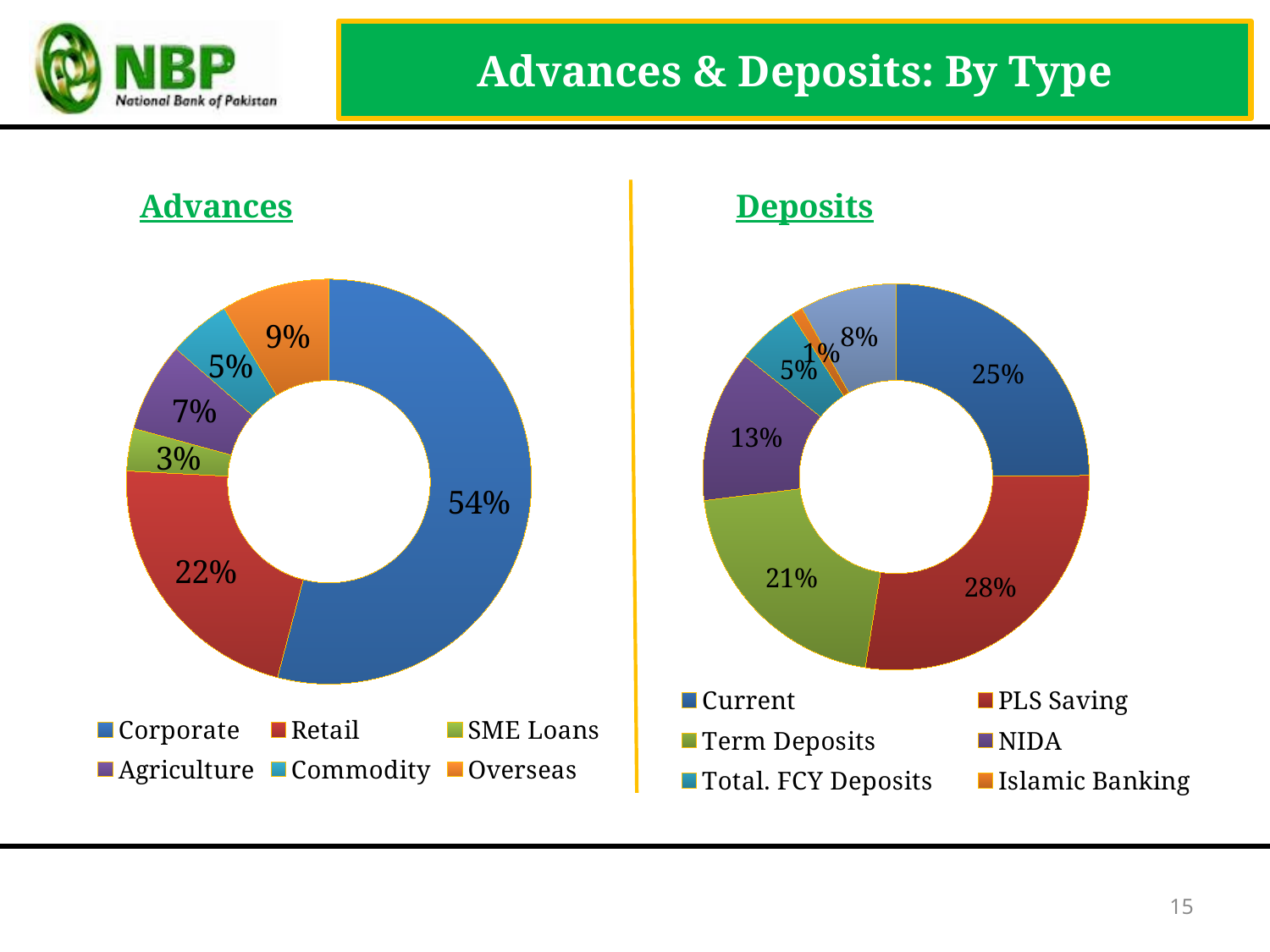
In the Advances chart, what share of advances is Corporate? 54% In the Deposits chart, what share is PLS Saving? 28% In the Deposits chart, what percentage is shown for Islamic Banking? 1% In the Advances chart, which category has the smallest share? SME Loans In the Advances chart, what is the difference in percentage points between Corporate and Retail? 32 What type of chart is used for Advances? Doughnut chart In the Deposits chart, which category has the largest share? PLS Saving How many categories does the Advances chart's legend list? 6 In the Deposits chart, what is the difference in percentage points between Current and Term Deposits? 4 In the Advances chart, which is larger, Agriculture or Commodity? Agriculture In the Deposits chart, what percentage is shown for NIDA? 13% In the Advances chart, what percentage is shown for Retail? 22%